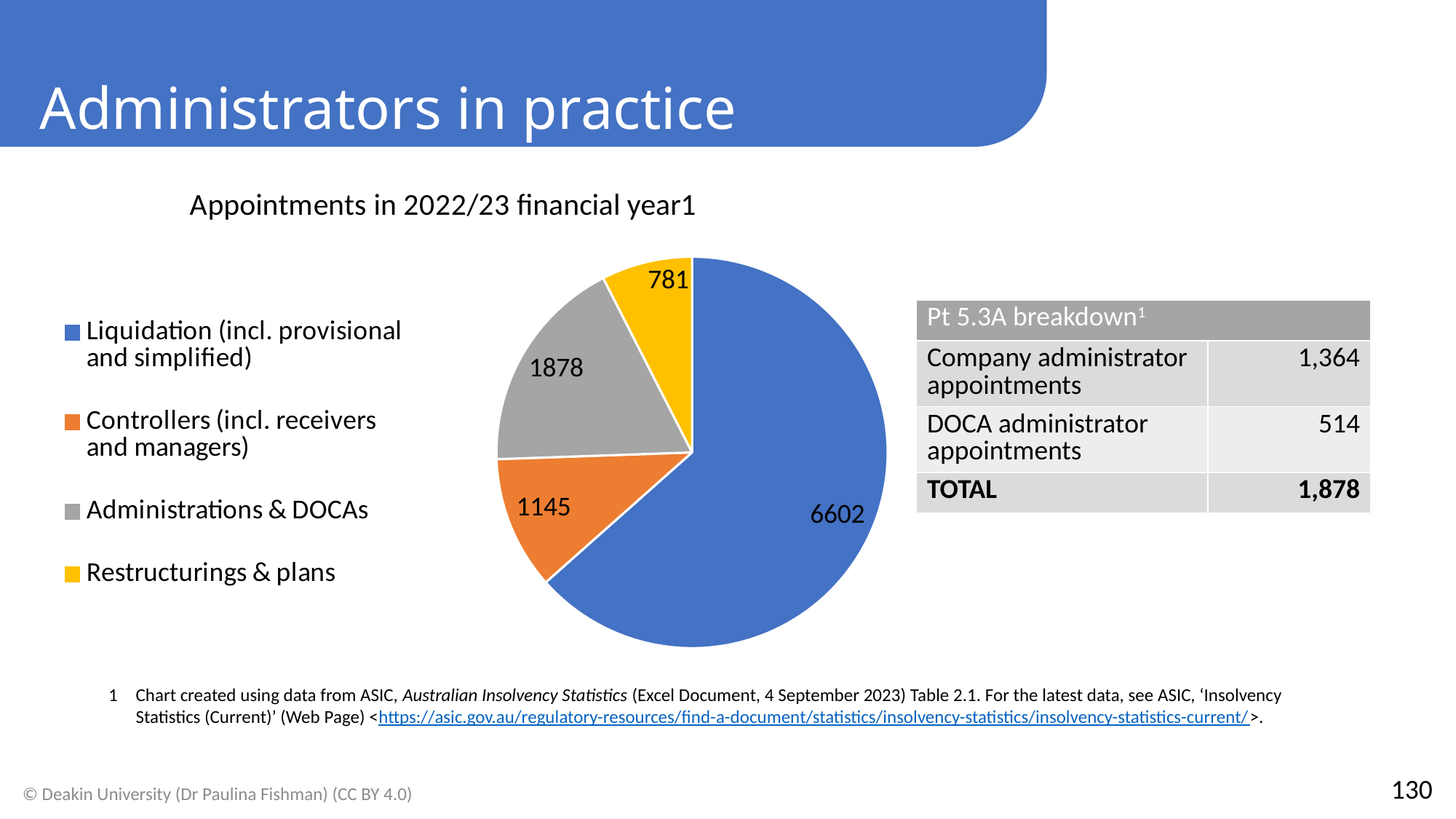
Which category has the smallest slice in the pie chart? Restructurings & plans How many categories does the pie chart show? 4 Which colour represents Administrations & DOCAs in the pie chart? grey What is the difference between the values for Administrations & DOCAs and Controllers (incl. receivers and managers)? 733 Which category has the largest slice in the pie chart? Liquidation (incl. provisional and simplified) What is the value for Restructurings & plans in the pie chart? 781 What is the value for Administrations & DOCAs in the pie chart? 1878 What is the value for Controllers (incl. receivers and managers) in the pie chart? 1145 What type of chart is shown on the slide? pie chart What is the title of the pie chart? Appointments in 2022/23 financial year1 Which is larger: the value for Controllers (incl. receivers and managers) or the value for Restructurings & plans? Controllers (incl. receivers and managers) What is the value for Liquidation (incl. provisional and simplified) in the pie chart? 6602